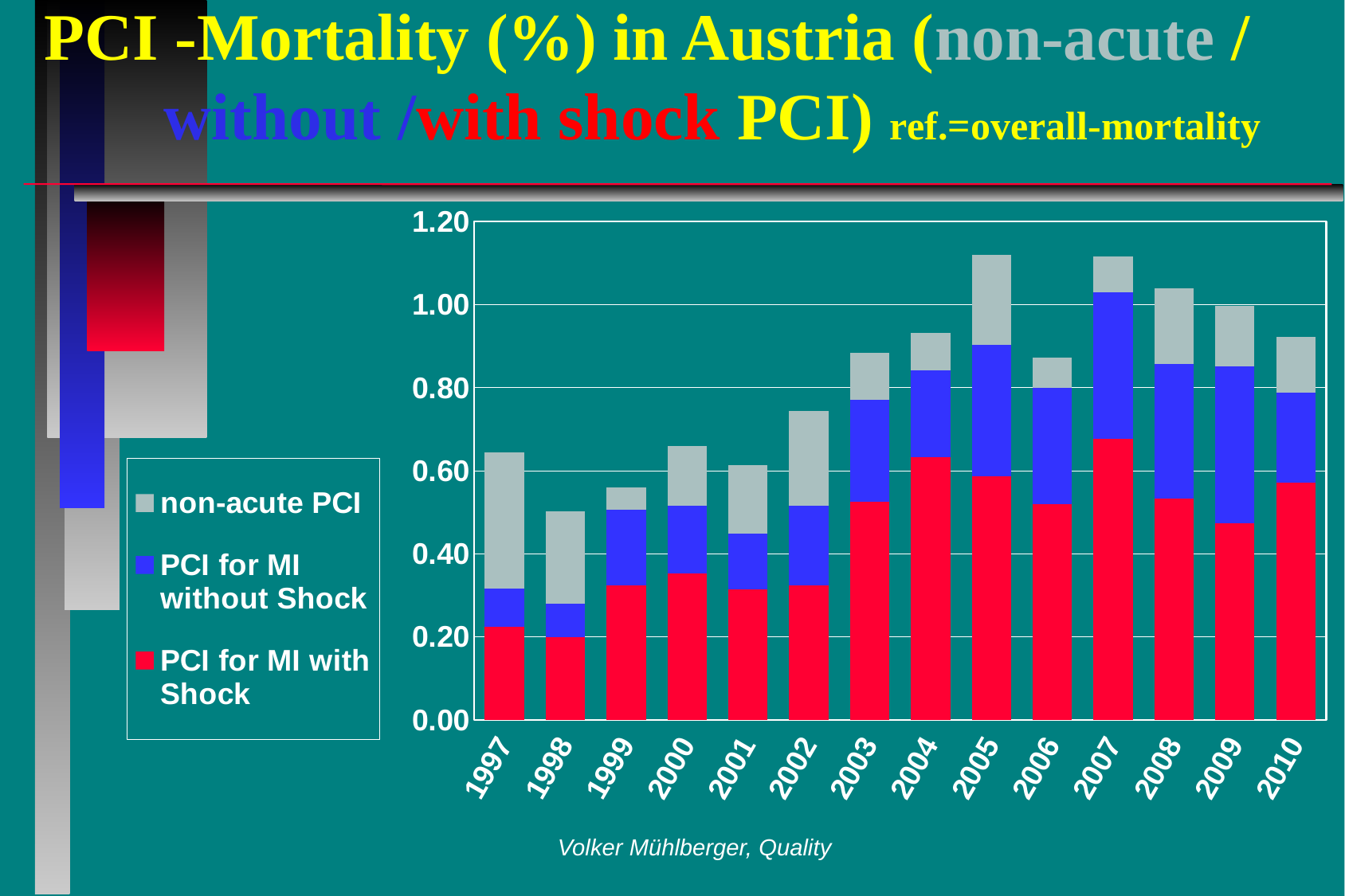
How many series does the chart's legend list? 3 Which colour represents 'PCI for MI with Shock' in the chart? Red Is the total stacked value for 1998 greater or less than 0.60? less Is the total stacked value for 2010 greater or less than 1.00? less Which year has the lowest total stacked bar? 1998 Do the total stacked values rise or fall from 2007 to 2010? fall Which year has the largest 'PCI for MI with Shock' segment? 2007 Is the 'PCI for MI with Shock' value for 2007 greater or less than 0.60? greater Which year has the larger total stacked bar, 2002 or 2003? 2003 How many years are shown on the x axis of the chart? 14 What kind of chart is shown on the slide? Stacked bar chart